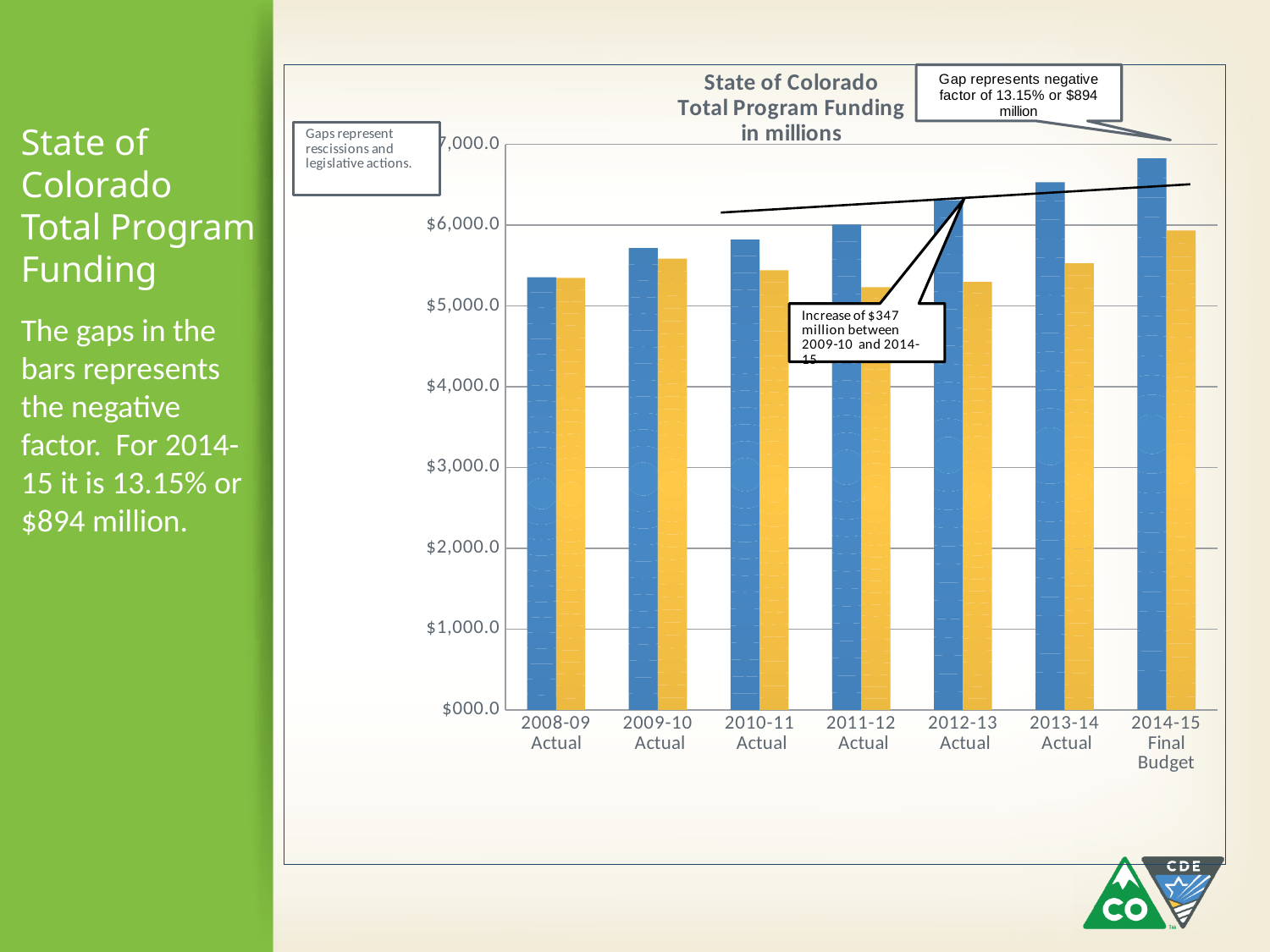
Is the yellow bar for 2011-12 Actual greater or less than $6,000.0? less What is the title of the chart? State of Colorado Total Program Funding in millions How many fiscal-year categories are shown on the x axis of the chart? 7 Is the blue bar for 2014-15 Final Budget greater or less than $6,000.0? greater Which category has the shortest blue bar? 2008-09 Actual Which category has the tallest blue bar? 2014-15 Final Budget Is the blue bar for 2008-09 Actual greater or less than $5,000.0? greater For 2014-15 Final Budget, which bar is taller, the blue bar or the yellow bar? The blue bar What kind of chart is shown on the slide? Bar chart According to the annotation on the chart, what negative factor does the gap represent for 2014-15? 13.15% or $894 million Which category has the tallest yellow bar? 2014-15 Final Budget Do the blue bars generally rise or fall from 2008-09 Actual to 2014-15 Final Budget? Rise